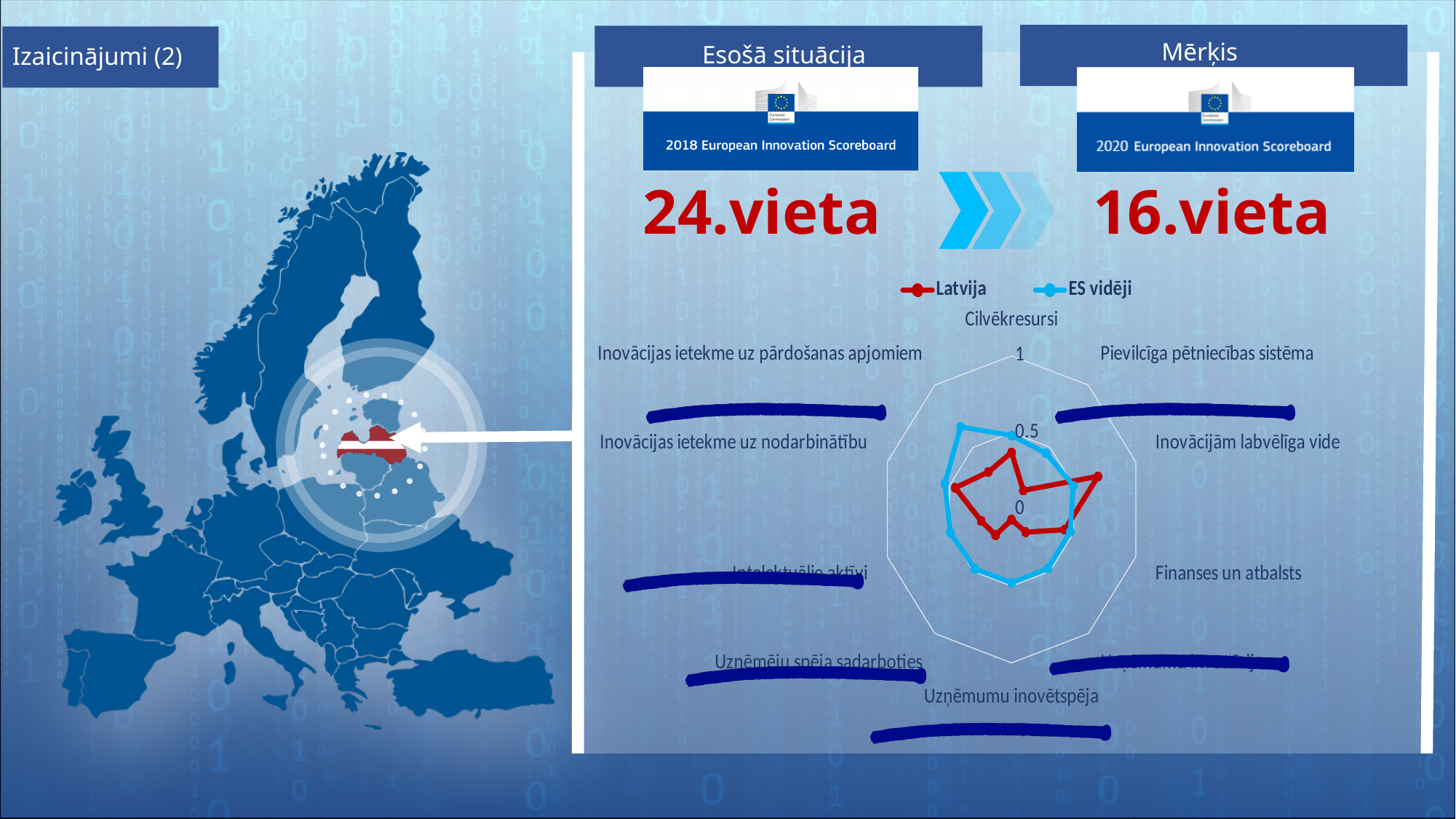
What are the two series named in the chart's legend? Latvija and ES vidēji Is the Latvija value for Cilvēkresursi greater or less than 0.5? less Which colour represents the Latvija series in the chart? red Is the Latvija value for Pievilcīga pētniecības sistēma greater or less than 0.5? less How many series does the chart's legend list? 2 What kind of chart is shown on the slide? radar chart For Uzņēmumu inovētspēja, which series has the larger value, Latvija or ES vidēji? ES vidēji For Inovācijām labvēlīga vide, which series has the larger value, Latvija or ES vidēji? Latvija In which category does the Latvija series reach its highest value? Inovācijām labvēlīga vide Is the ES vidēji value for Cilvēkresursi greater or less than 1? less For Pievilcīga pētniecības sistēma, which series has the larger value, Latvija or ES vidēji? ES vidēji